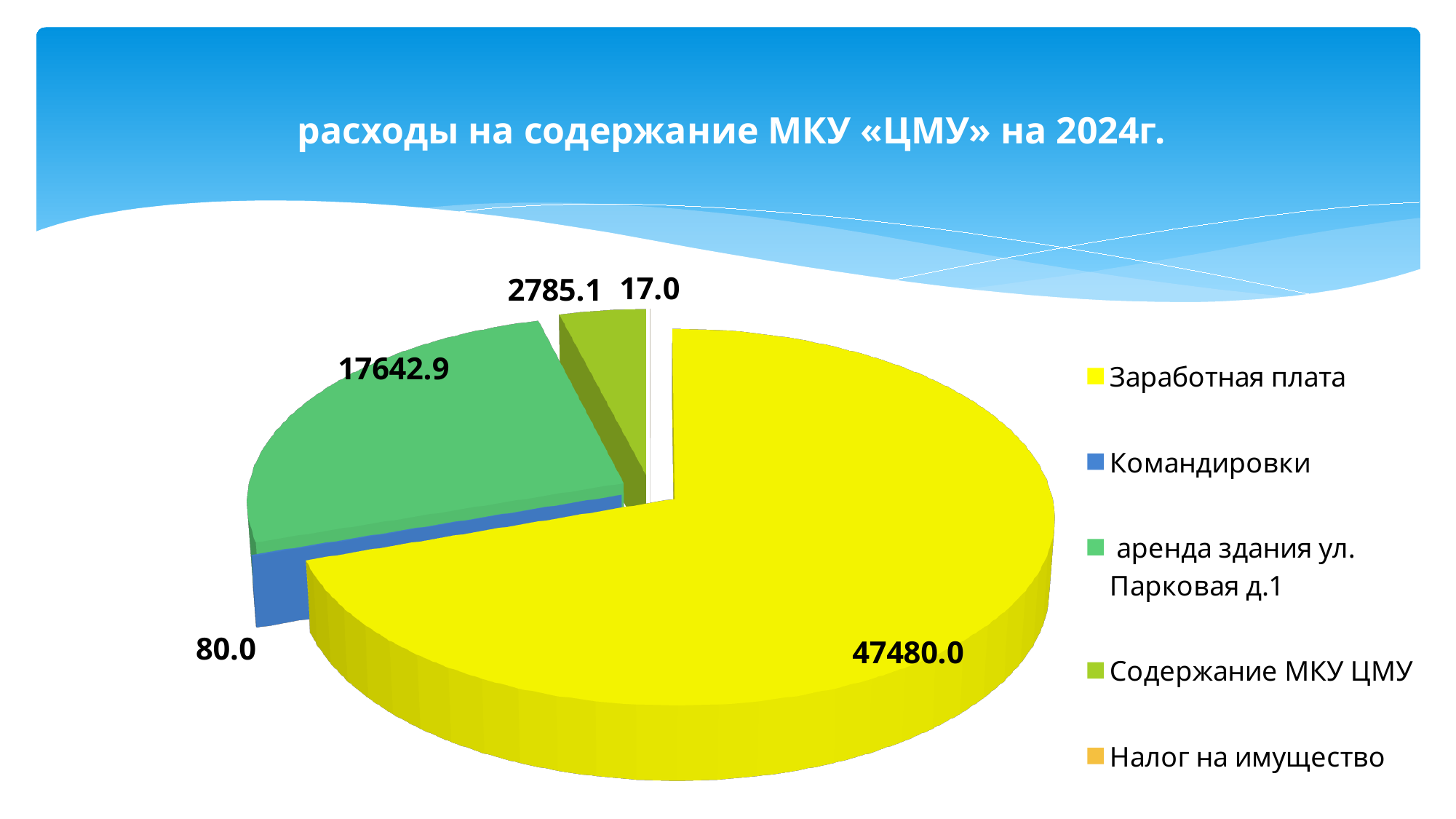
What is the difference between Заработная плата and аренда здания ул. Парковая д.1? 29837.1 What is the value for Командировки? 80.0 What is the value for Заработная плата? 47480.0 What is the value for аренда здания ул. Парковая д.1? 17642.9 Which category has the largest value? Заработная плата What is the value for Налог на имущество? 17.0 What kind of chart is shown on the slide? Pie chart What is the difference between Содержание МКУ ЦМУ and Командировки? 2705.1 Which is larger, Командировки or Содержание МКУ ЦМУ? Содержание МКУ ЦМУ How many categories does the pie chart show? 5 Which category has the smallest value? Налог на имущество What is the value for Содержание МКУ ЦМУ? 2785.1